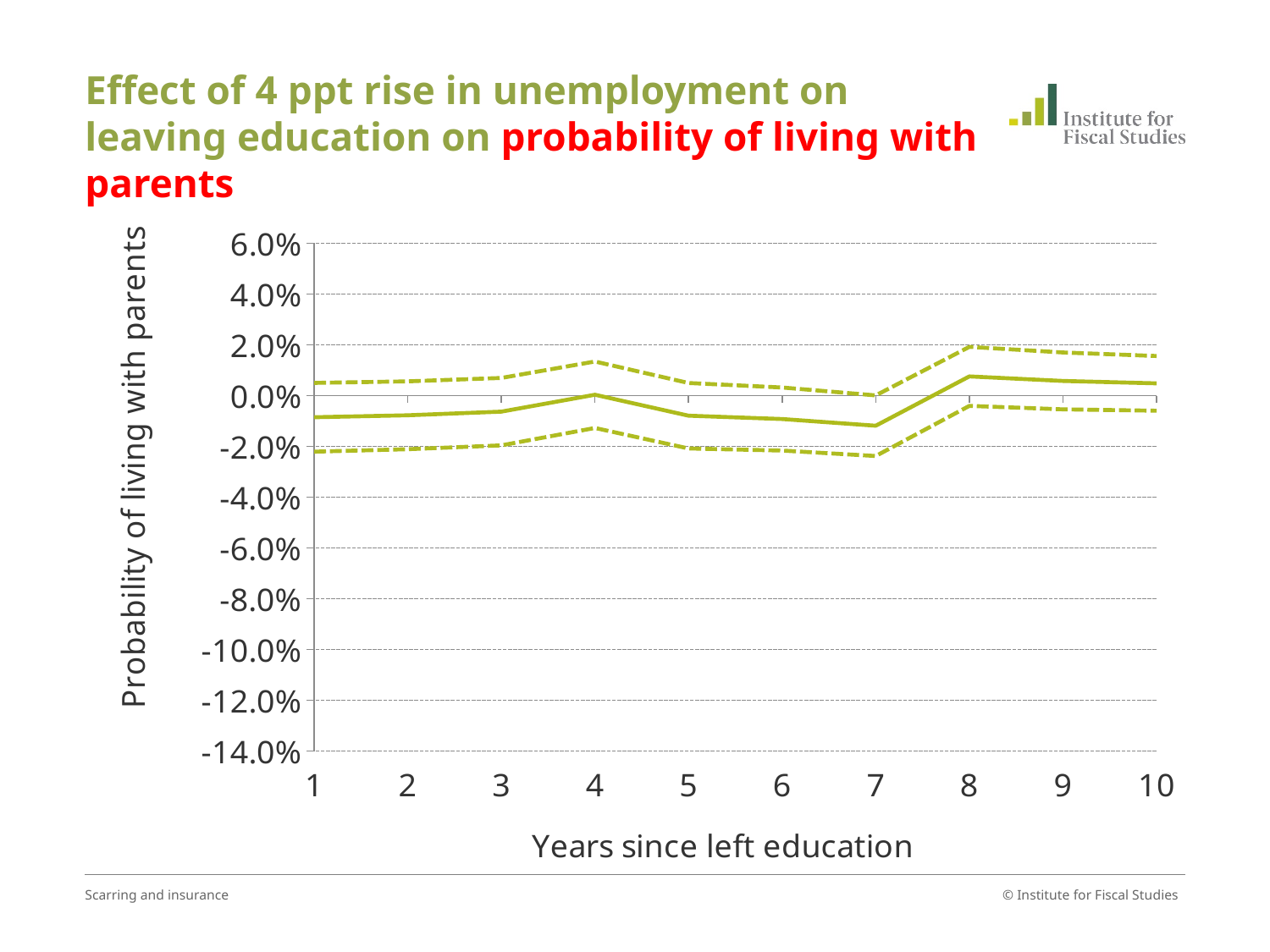
What kind of chart is shown on the slide? line chart Is the value of the upper dashed line at year 4 greater or less than 2.0%? less Is the value of the lower dashed line at year 4 greater or less than -2.0%? greater At which year does the solid line reach its highest value? 8 How many points along the x axis (years since left education) does the chart cover? 10 Is the value of the solid line at year 7 greater or less than 0.0%? less Which is larger for the solid line: the value at year 4 or the value at year 7? year 4 Does the solid line rise or fall between year 7 and year 8? rise What is the title of the y axis? Probability of living with parents What is the title of the x axis? Years since left education